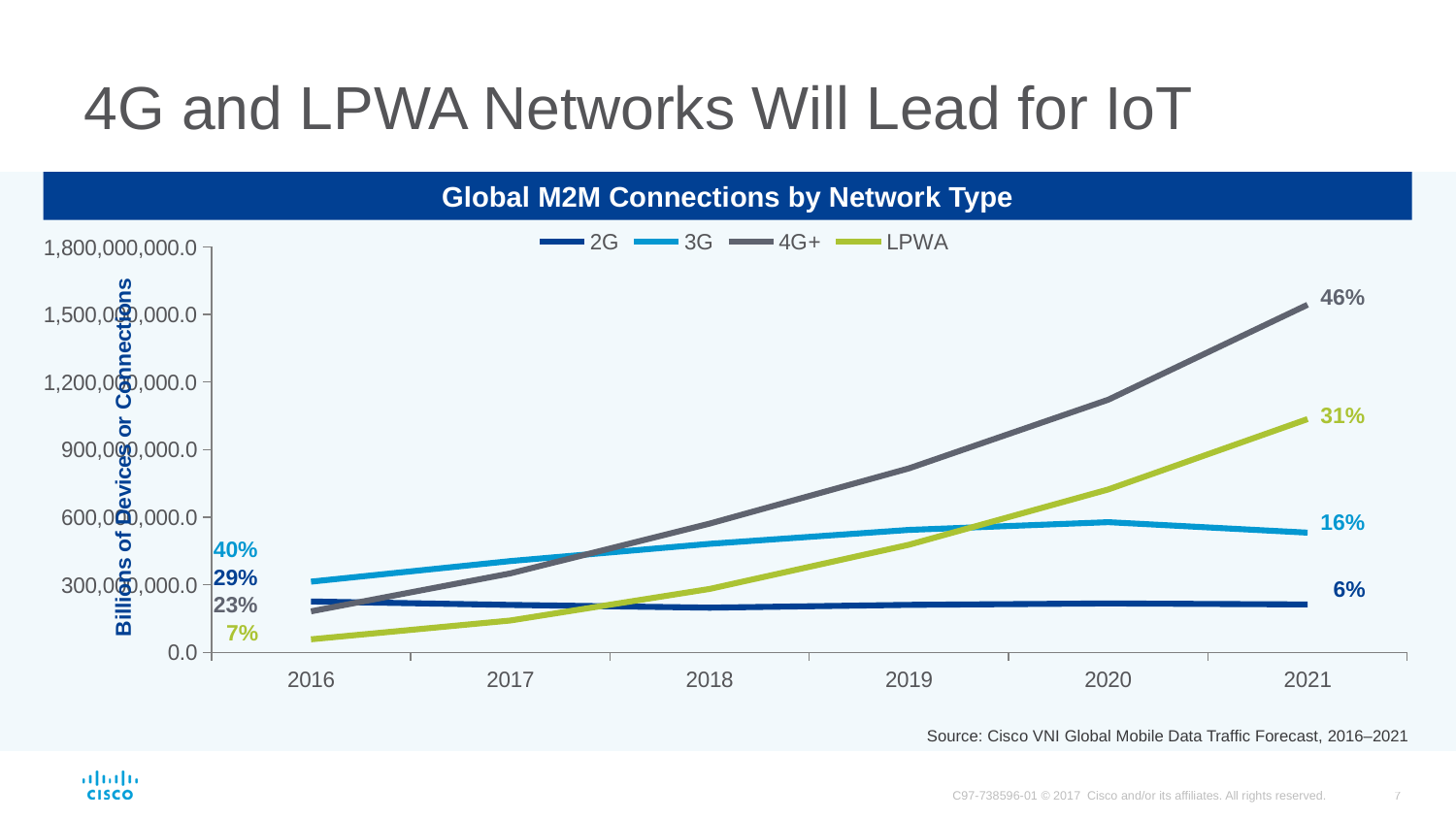
Which network type has the highest number of connections in 2021? 4G+ Is the value for LPWA in 2021 greater or less than 900,000,000.0? greater Does the 4G+ line rise or fall from 2016 to 2021? Rises How many series does the legend list? 4 What share is labelled for LPWA in 2016? 7% What share of global M2M connections is labelled for 4G+ in 2021? 46% What share is labelled for 3G in 2021? 16% In 2016, which has more connections, 3G or 2G? 3G What is the title of the chart? Global M2M Connections by Network Type How many years are shown along the x axis? 6 Which network type has the lowest number of connections in 2021? 2G What kind of chart is shown on the slide? Line chart